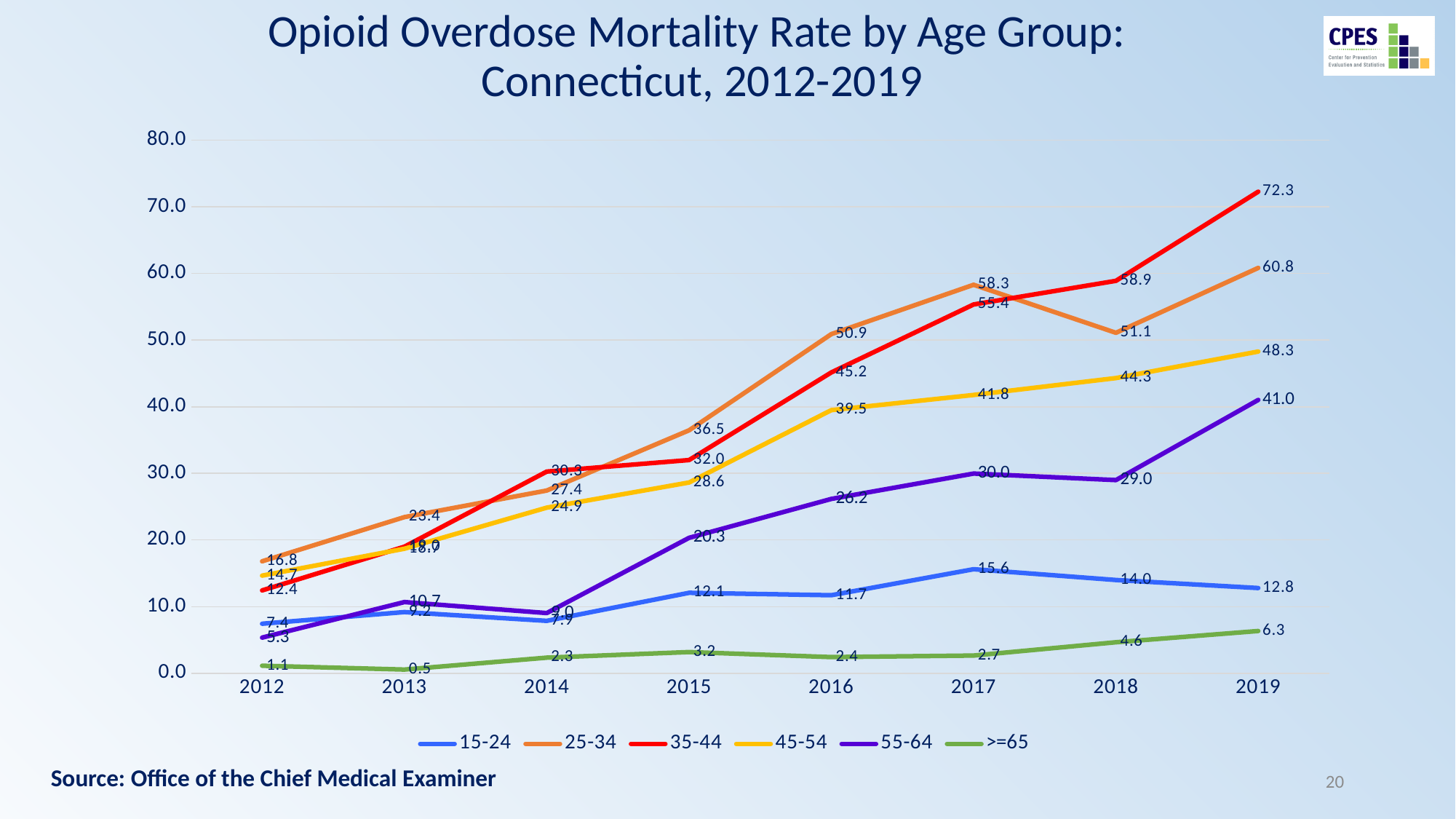
What type of chart is shown on the slide? line chart Which is larger in 2018: the mortality rate for 45-54 or for 55-64? 45-54 What is the mortality rate for the 35-44 age group in 2019? 72.3 How many series does the legend list? 6 What is the mortality rate for the 25-34 age group in 2017? 58.3 Which age group has the highest mortality rate in 2019? 35-44 Does the mortality rate for the 45-54 age group generally rise or fall from 2012 to 2019? rise What is the source cited at the bottom of the slide? Office of the Chief Medical Examiner How many years are plotted along the x axis? 8 What is the difference between the 2019 mortality rates of the 35-44 and 25-34 age groups? 11.5 What is the mortality rate for the >=65 age group in 2013? 0.5 Which age group has the lowest mortality rate in 2012? >=65